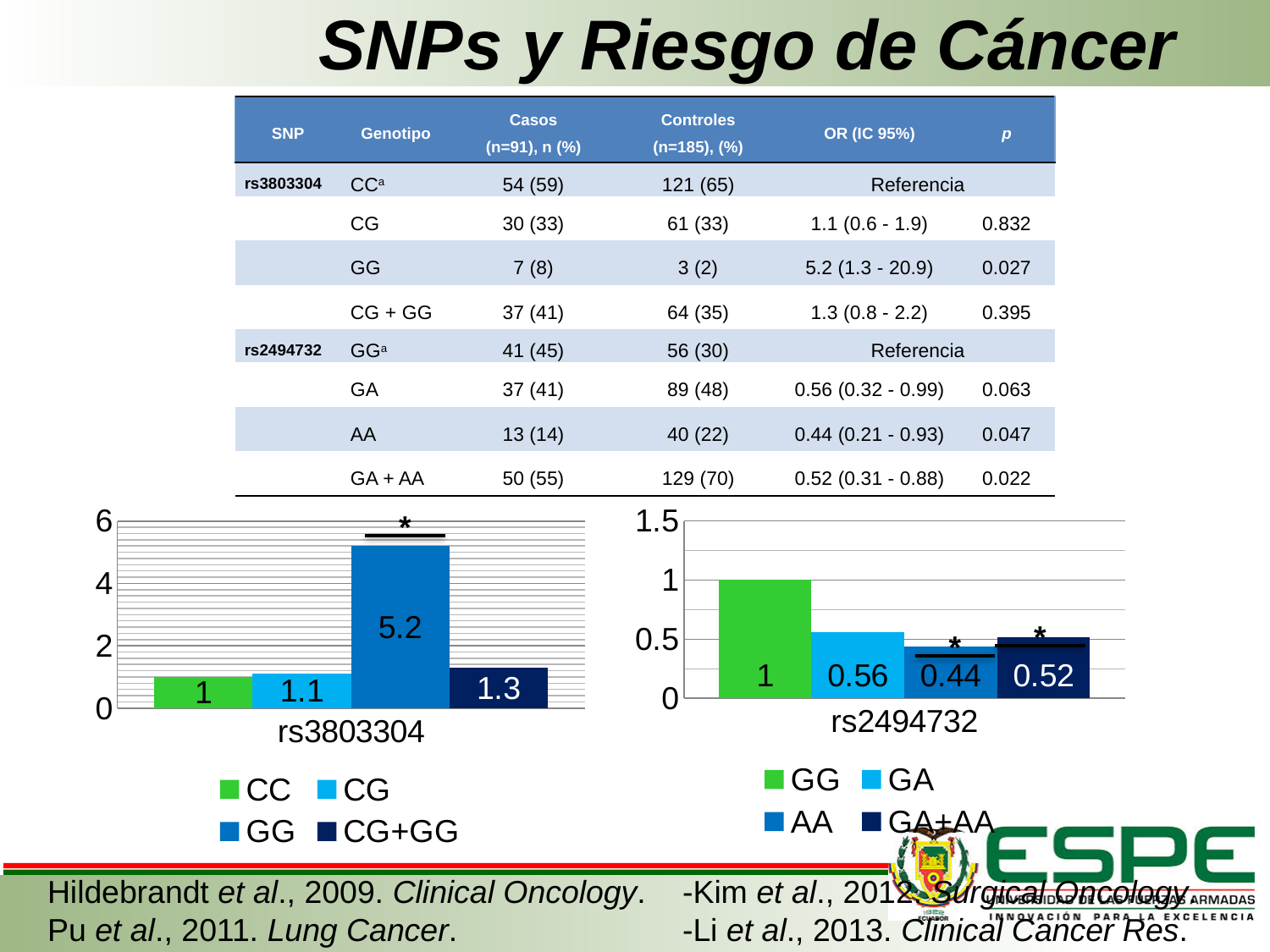
In the right chart (rs2494732), which is larger, the value for GA or the value for AA? GA In the right chart (rs2494732), which genotype has the lowest value? AA In the left chart (rs3803304), what is the value for CG+GG? 1.3 In the right chart (rs2494732), what is the value for GA? 0.56 In the right chart (rs2494732), what is the difference between the values for GG and GA+AA? 0.48 In the left chart (rs3803304), which genotype has the highest value? GG In the left chart (rs3803304), what is the difference between the values for GG and CC? 4.2 In the left chart (rs3803304), what is the value for GG? 5.2 In the right chart (rs2494732), what is the value for AA? 0.44 How many series does the legend of the left chart (rs3803304) list? 4 In the right chart (rs2494732), is the value for GG greater or less than 0.5? greater What kind of chart is the right chart (rs2494732)? bar chart